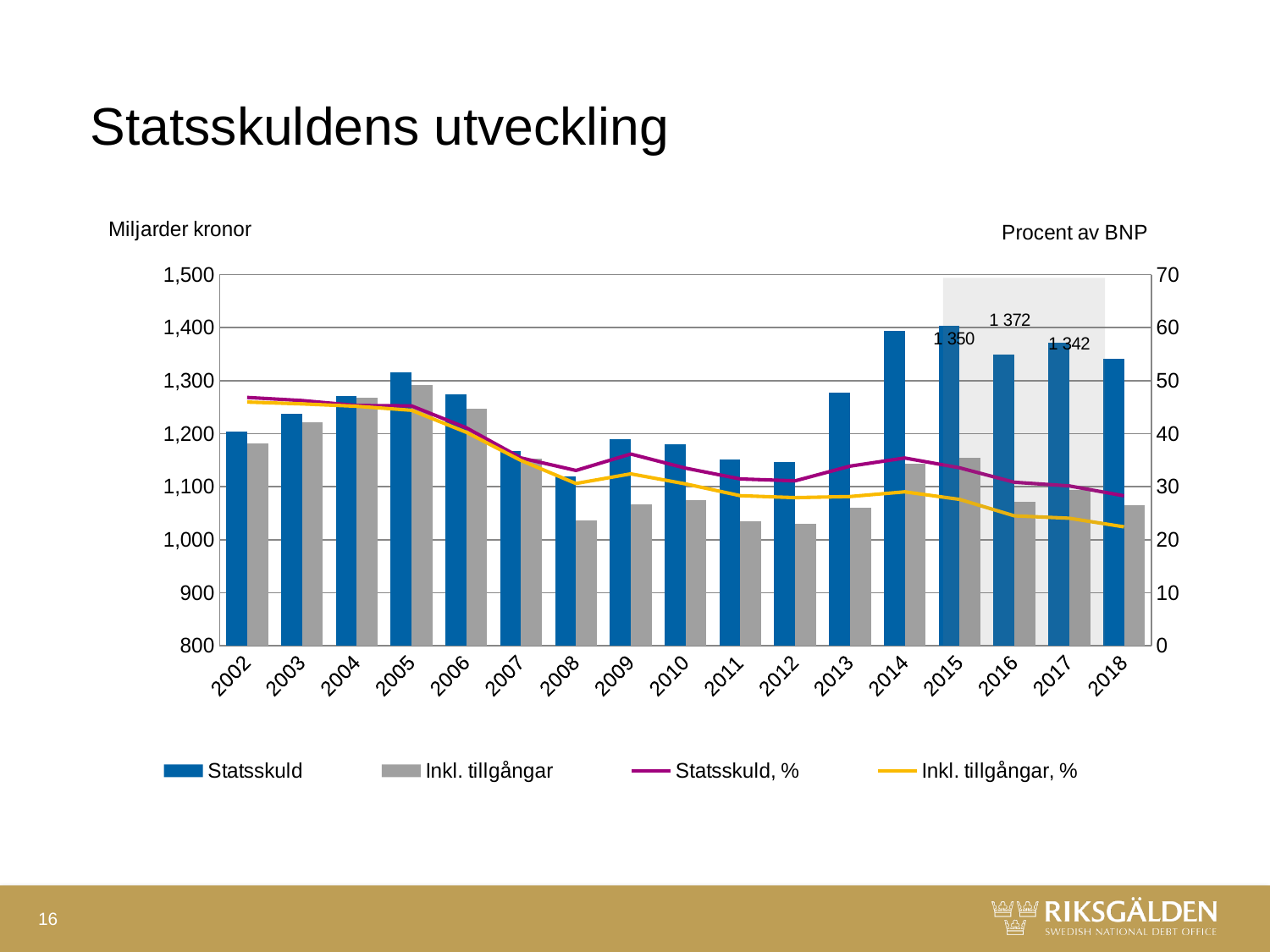
Is the Inkl. tillgångar bar for 2008 greater or less than 1,100? less Is the Statsskuld, % line for 2002 greater or less than 40 on the right axis? greater What kind of chart is shown on the slide? A combined bar and line chart In which year is the Statsskuld bar highest? 2015 In which year is the Inkl. tillgångar bar highest? 2005 What unit label is shown above the left axis? Miljarder kronor Does the Statsskuld, % line rise or fall from 2002 to 2008? fall How many series does the legend list? 4 How many years are shown on the x axis? 17 Is the Statsskuld bar for 2013 greater or less than 1,200? greater Which is larger, the Statsskuld bar for 2005 or for 2006? 2005